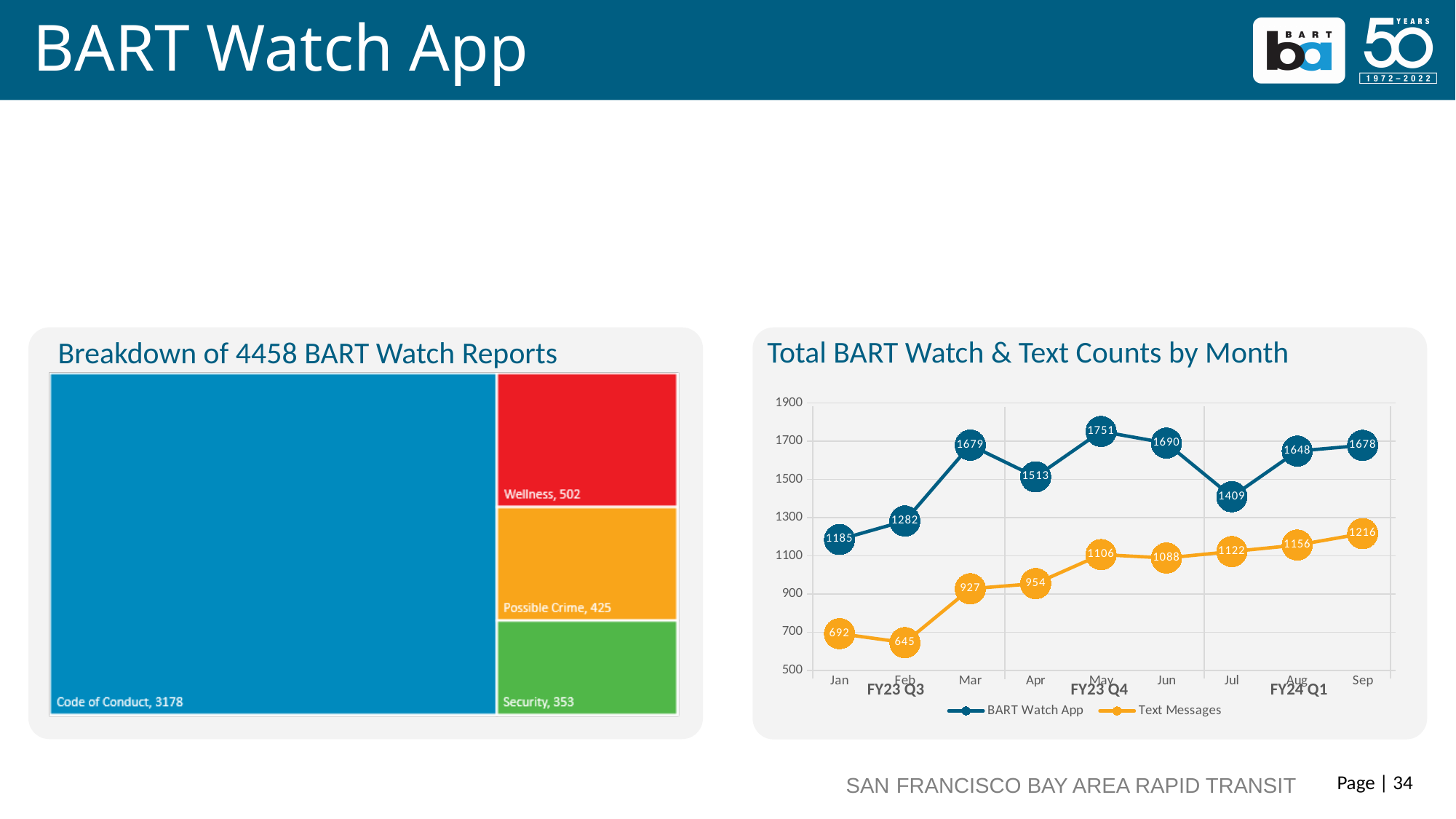
In the 'Total BART Watch & Text Counts by Month' chart, what is the Text Messages value for Feb? 645 In the 'Breakdown of 4458 BART Watch Reports' chart, what is the difference between Wellness and Possible Crime? 77 In the 'Total BART Watch & Text Counts by Month' chart, which month has the lowest BART Watch App value? Jan In the 'Total BART Watch & Text Counts by Month' chart, how many series does the legend list? 2 In the 'Breakdown of 4458 BART Watch Reports' chart, which category has the lowest value? Security In the 'Total BART Watch & Text Counts by Month' chart, is the BART Watch App value for Jun larger or smaller than the value for Jul? larger In the 'Breakdown of 4458 BART Watch Reports' chart, how many categories are shown? 4 What kind of chart is 'Total BART Watch & Text Counts by Month'? line chart In the 'Total BART Watch & Text Counts by Month' chart, what is the BART Watch App value for May? 1751 In the 'Total BART Watch & Text Counts by Month' chart, which month has the highest Text Messages value? Sep In the 'Breakdown of 4458 BART Watch Reports' chart, what is the value for Code of Conduct? 3178 In the 'Total BART Watch & Text Counts by Month' chart, what is the difference between the BART Watch App and Text Messages values in Jul? 287